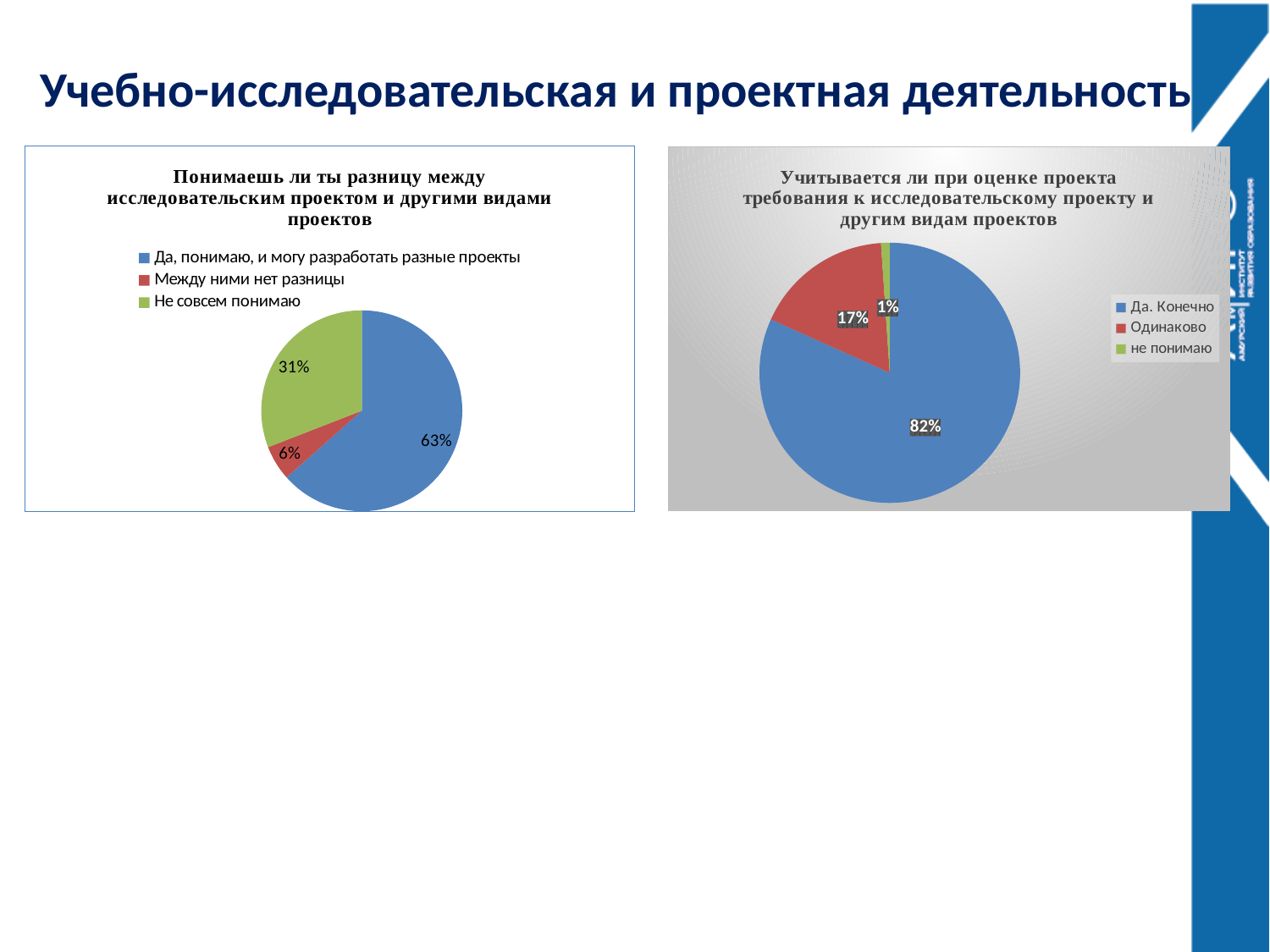
In the right chart, what share is labelled for "не понимаю"? 1% In the left chart, what is the difference in percentage points between "Да, понимаю, и могу разработать разные проекты" and "Не совсем понимаю"? 32 percentage points In the left chart, what share is labelled for "Между ними нет разницы"? 6% In the right chart, which category has the largest slice? Да. Конечно In the right chart, what share is labelled for "Одинаково"? 17% How many categories does the legend of the right chart list? 3 In the left chart, which category has the smallest slice? Между ними нет разницы In the right chart ("Учитывается ли при оценке проекта требования к исследовательскому проекту и другим видам проектов"), what share is labelled for "Да. Конечно"? 82% What type of chart is the left chart? Pie chart In the left chart ("Понимаешь ли ты разницу между исследовательским проектом и другими видами проектов"), what share is labelled for "Да, понимаю, и могу разработать разные проекты"? 63% In the right chart, what is the difference in percentage points between "Да. Конечно" and "Одинаково"? 65 percentage points In the left chart, what share is labelled for "Не совсем понимаю"? 31%